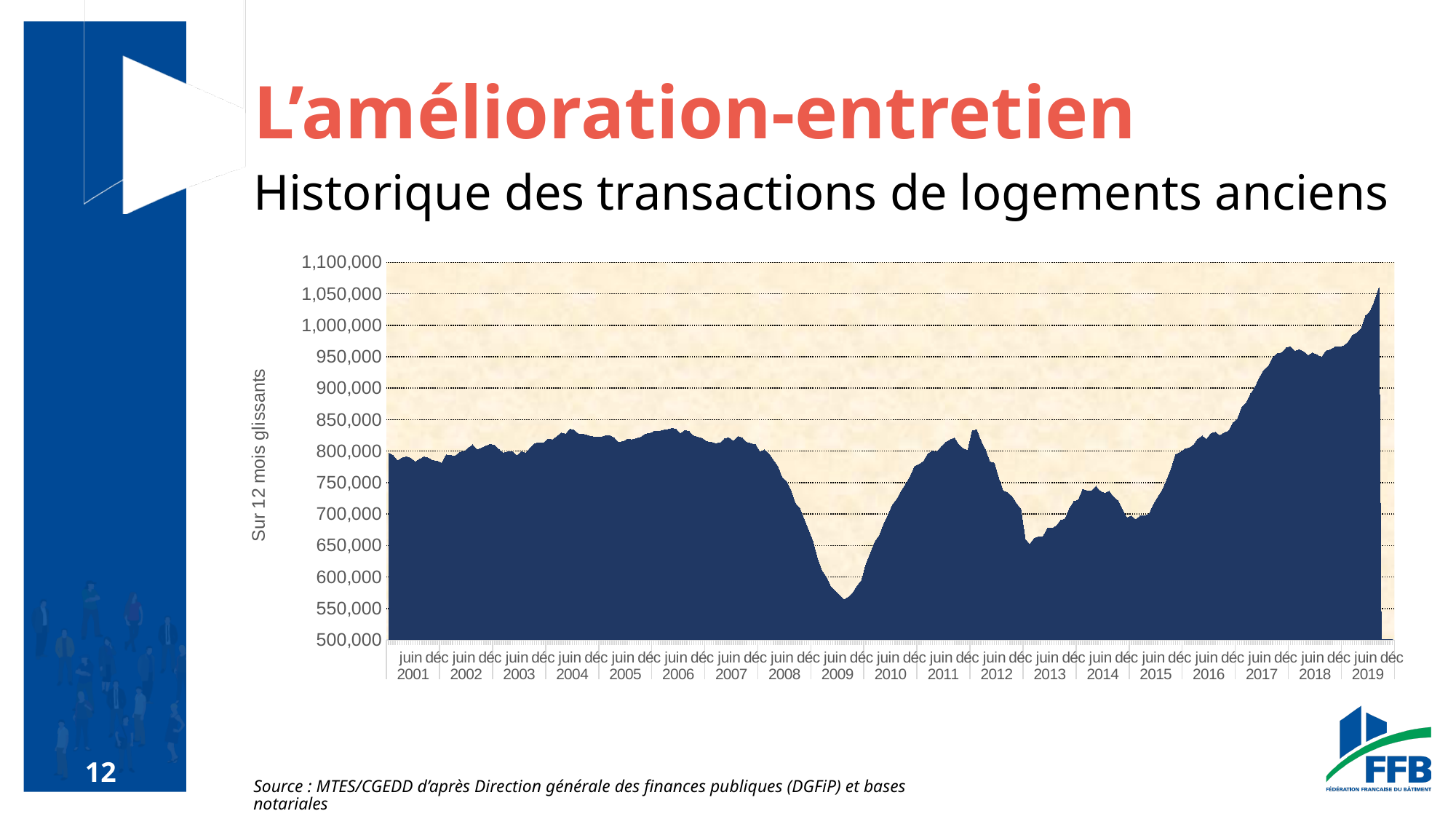
What is the label of the vertical axis? Sur 12 mois glissants Is the value at juin 2009 greater or less than 600,000? less In which year does the series reach its lowest value? 2009 In which year does the series reach its highest value? 2019 Does the series rise or fall between 2016 and 2019? rise Is the peak value in 2019 greater or less than 1,000,000? greater Does the series rise or fall between 2007 and 2009? fall Is the value at juin 2004 greater or less than 800,000? greater How many years are labelled on the x axis? 19 What kind of chart is shown on the slide? area chart